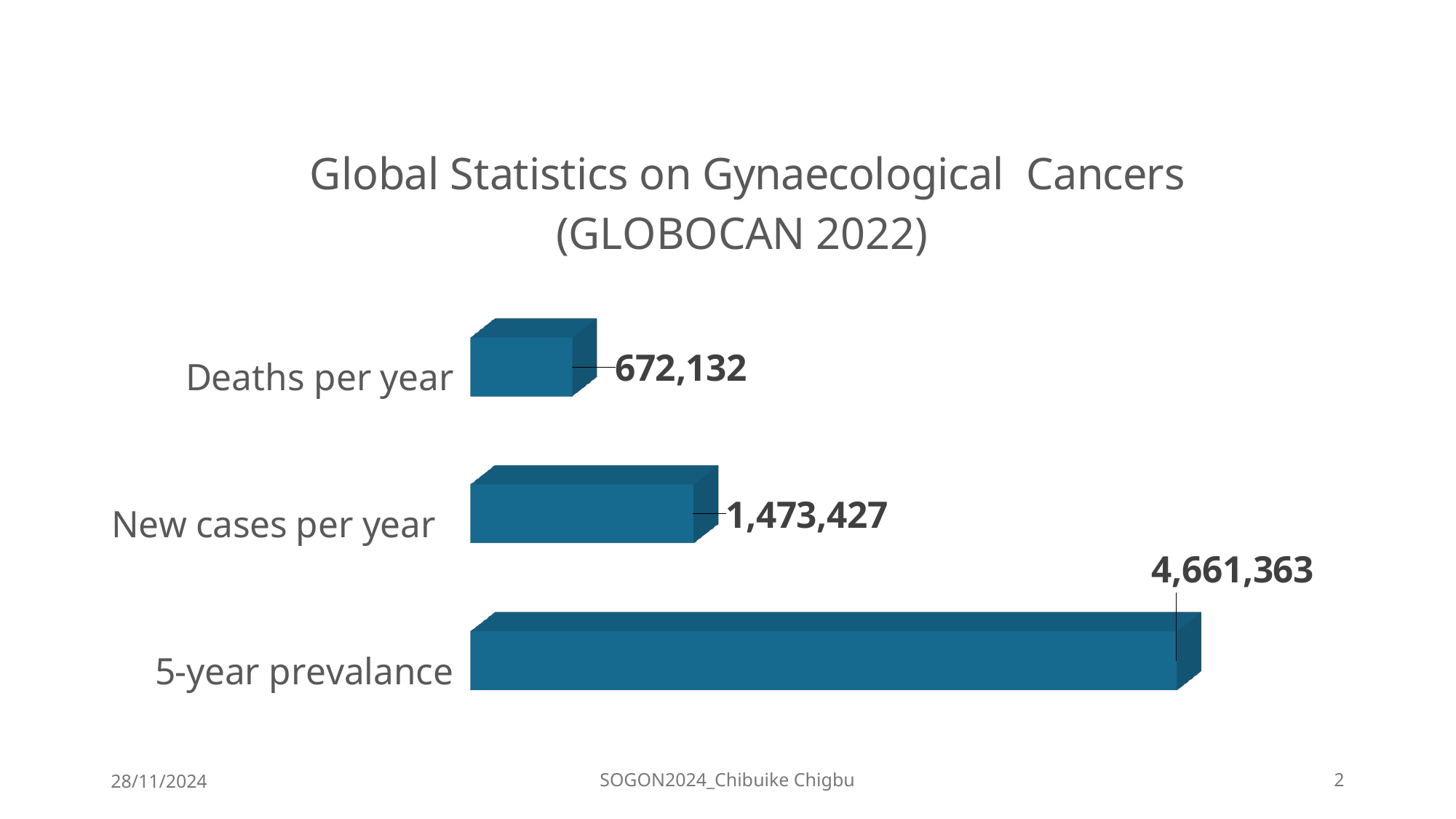
Which category has the highest value? 5-year prevalance What is the difference between New cases per year and Deaths per year? 801,295 What is the value for New cases per year? 1,473,427 Which is larger, New cases per year or Deaths per year? New cases per year What is the difference between 5-year prevalance and New cases per year? 3,187,936 What is the value for Deaths per year? 672,132 How many categories are shown in the chart? 3 What is the difference between 5-year prevalance and Deaths per year? 3,989,231 What is the value for 5-year prevalance? 4,661,363 What is the title of the chart? Global Statistics on Gynaecological Cancers (GLOBOCAN 2022) What kind of chart is shown on the slide? Bar chart Which category has the lowest value? Deaths per year